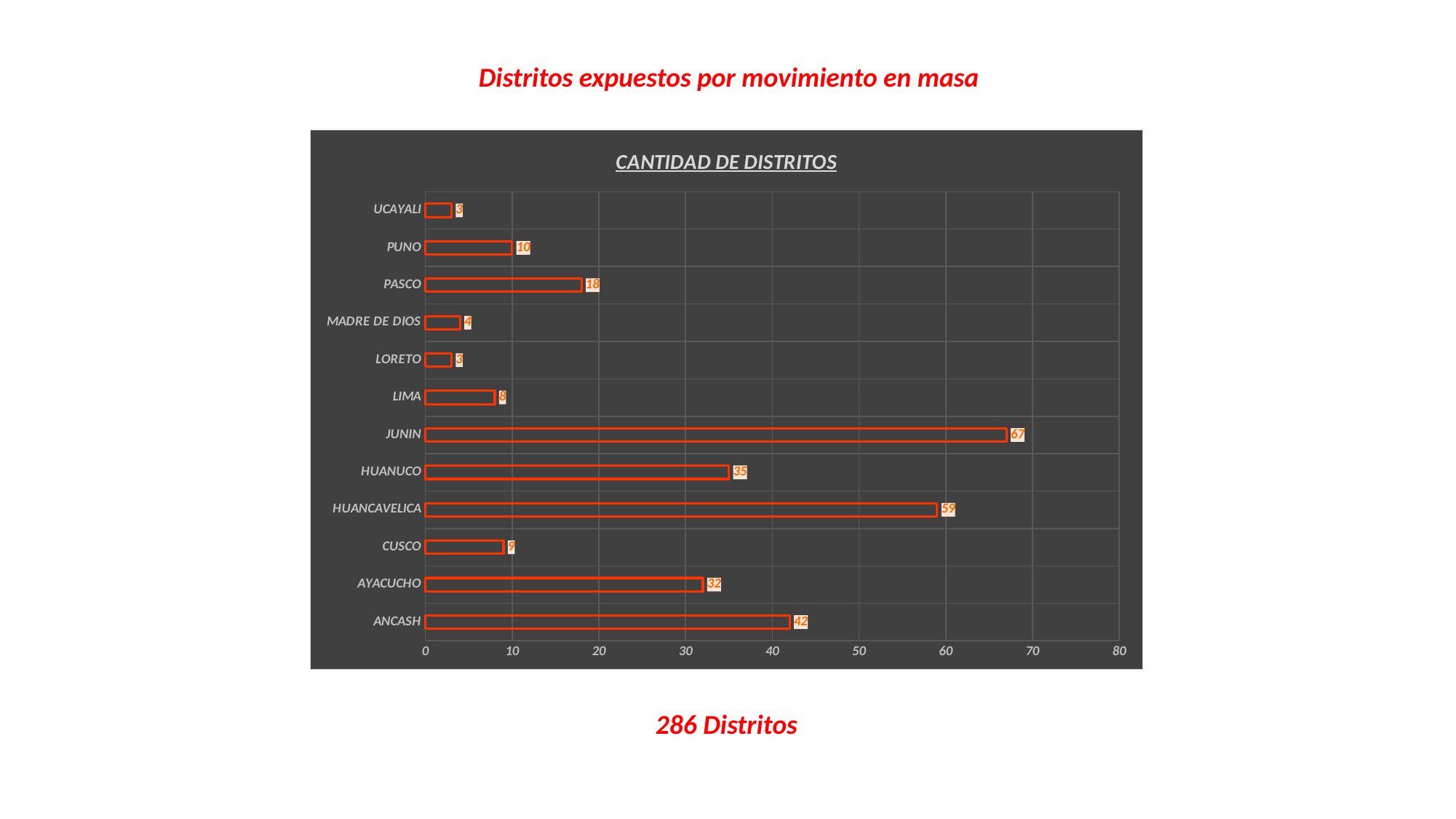
What is the value for JUNIN in the CANTIDAD DE DISTRITOS chart? 67 What is the value for HUANCAVELICA? 59 What is the title of the chart? CANTIDAD DE DISTRITOS How many categories are shown in the chart? 12 Is the value for ANCASH greater or less than 40? greater What is the value for PASCO? 18 What kind of chart is shown on the slide? bar chart Which is larger, the value for HUANUCO or the value for AYACUCHO? HUANUCO What is the difference between the values for JUNIN and HUANCAVELICA? 8 What is the value for MADRE DE DIOS? 4 Which category has the highest value? JUNIN What is the difference between the values for ANCASH and AYACUCHO? 10